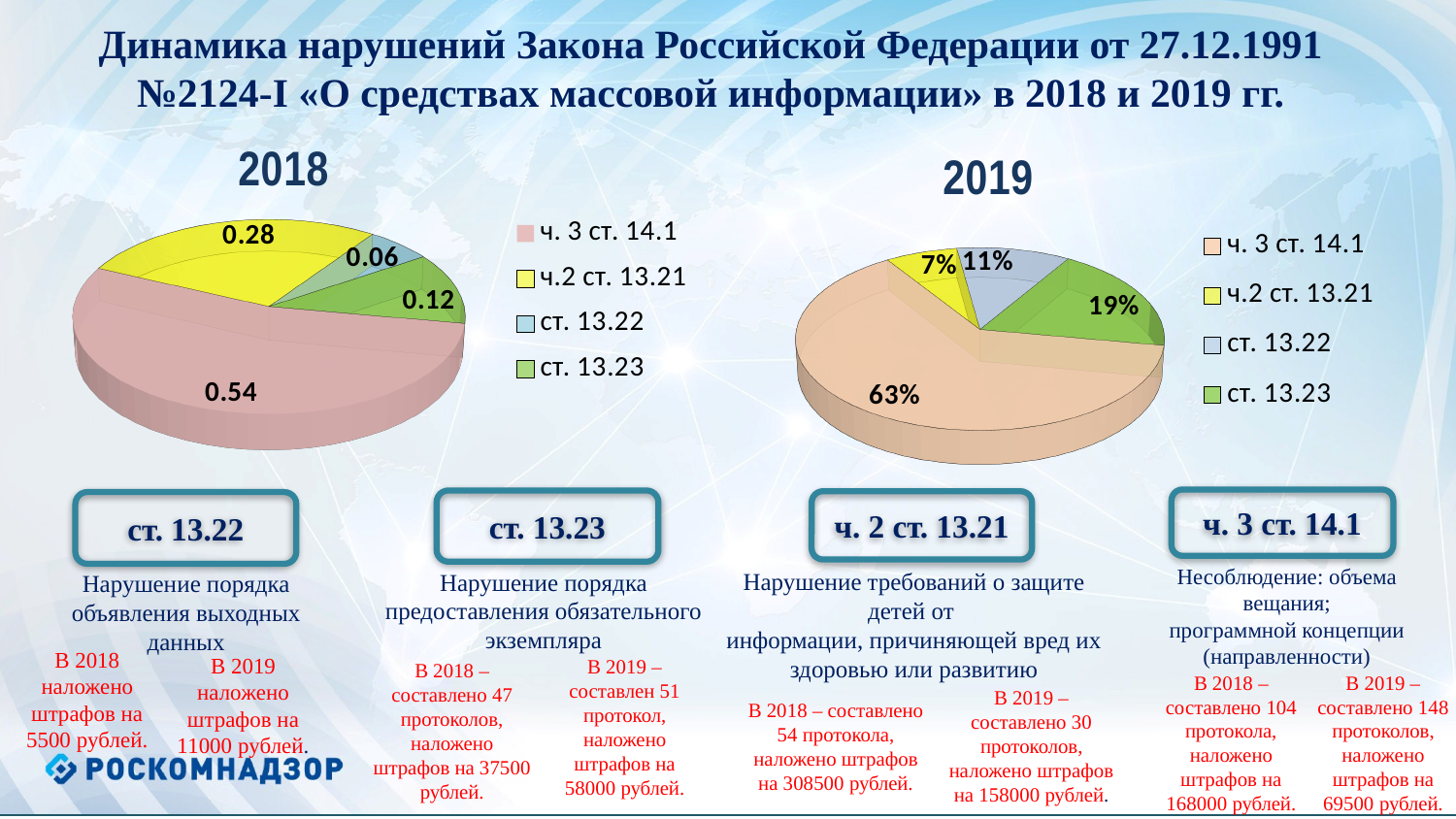
In the 2018 pie chart, what is the value shown for ч. 3 ст. 14.1? 0.54 In the 2019 pie chart, which category has the smallest share? ч.2 ст. 13.21 In the 2019 pie chart, what share is shown for ч.2 ст. 13.21? 7% In the 2019 pie chart, what share is shown for ст. 13.23? 19% In the 2018 pie chart, what is the value shown for ч.2 ст. 13.21? 0.28 What type of chart is used for the 2018 data? Pie chart In the 2018 pie chart, what is the value shown for ст. 13.22? 0.06 How many categories does the legend of the 2019 pie chart list? 4 In the 2018 pie chart, which category has the smallest value? ст. 13.22 In the 2019 pie chart, which category has the largest share? ч. 3 ст. 14.1 In the 2019 pie chart, which is larger: the share for ст. 13.22 or the share for ст. 13.23? ст. 13.23 In the 2018 pie chart, what is the difference between the values for ч.2 ст. 13.21 and ст. 13.23? 0.16